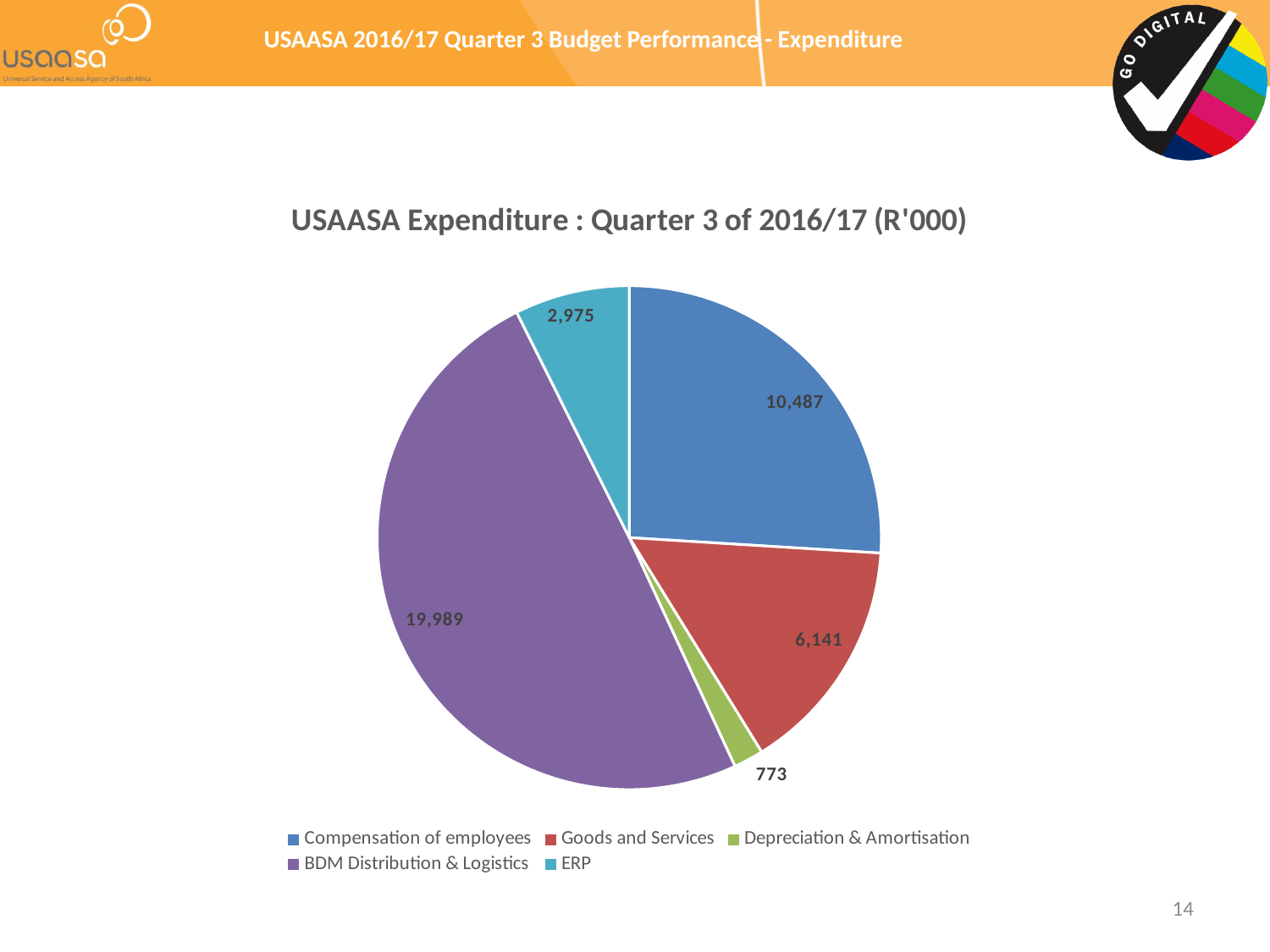
How many categories does the pie chart show? 5 What is the value for ERP? 2,975 What is the value for Compensation of employees? 10,487 Which is larger, Goods and Services or ERP? Goods and Services Which category has the largest slice of the pie? BDM Distribution & Logistics What is the value for Depreciation & Amortisation? 773 What type of chart is shown on the slide? Pie chart What is the value for Goods and Services? 6,141 What is the difference between BDM Distribution & Logistics and Compensation of employees? 9,502 What is the value for BDM Distribution & Logistics? 19,989 Which category has the smallest slice of the pie? Depreciation & Amortisation What is the title of the chart? USAASA Expenditure : Quarter 3 of 2016/17 (R'000)